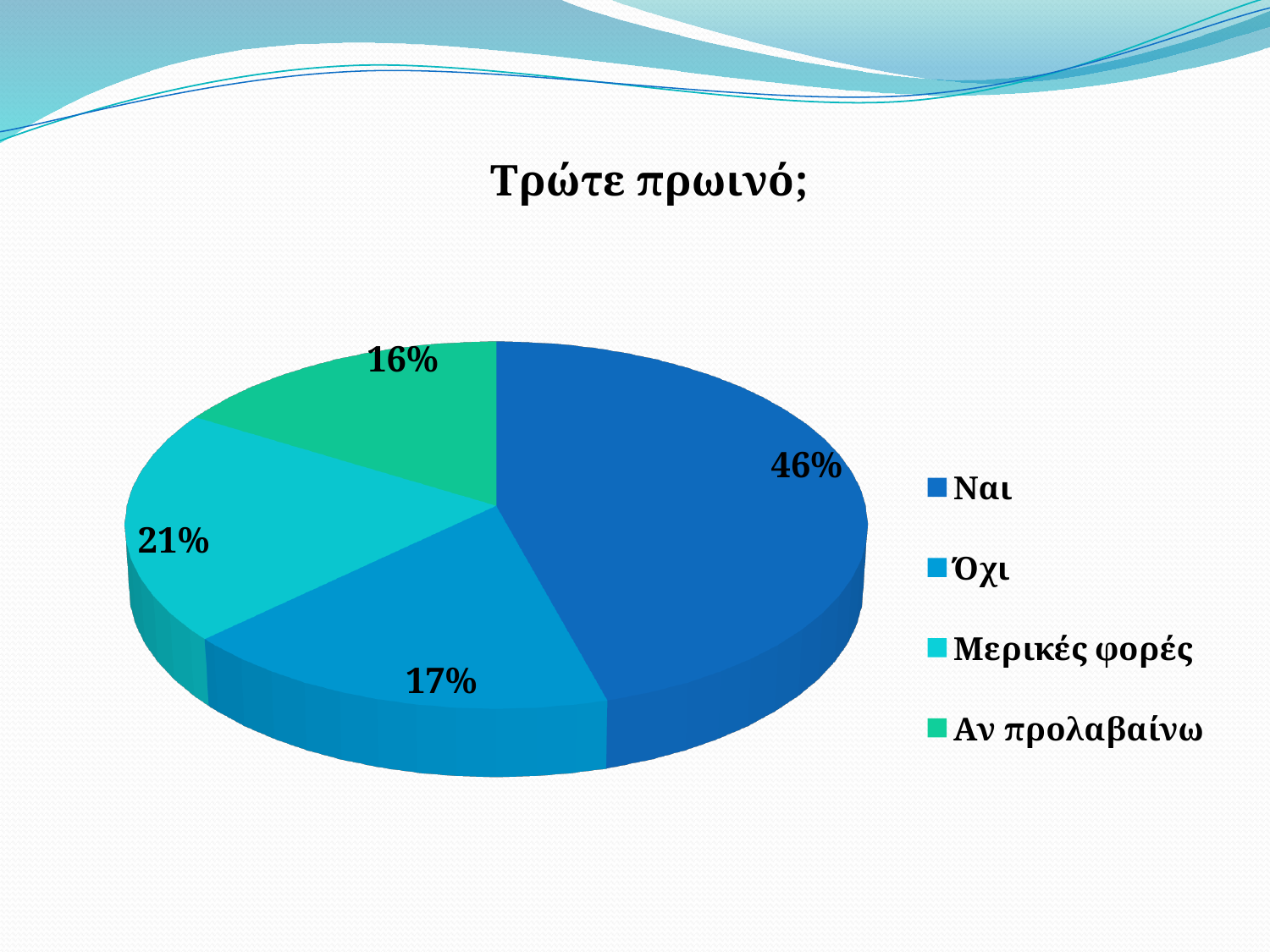
What percentage of the pie is the 'Ναι' slice? 46% What colour is the 'Ναι' slice? dark blue What percentage of the pie is the 'Μερικές φορές' slice? 21% Which slice is larger, 'Μερικές φορές' or 'Όχι'? Μερικές φορές What type of chart is shown on the slide? pie chart Which category has the smallest share of the pie? Αν προλαβαίνω Which category has the largest share of the pie? Ναι What is the difference in percentage points between the 'Ναι' and 'Όχι' slices? 29 How many categories does the legend list? 4 What percentage of the pie is the 'Αν προλαβαίνω' slice? 16% What percentage of the pie is the 'Όχι' slice? 17% What is the title of the chart? Τρώτε πρωινό;